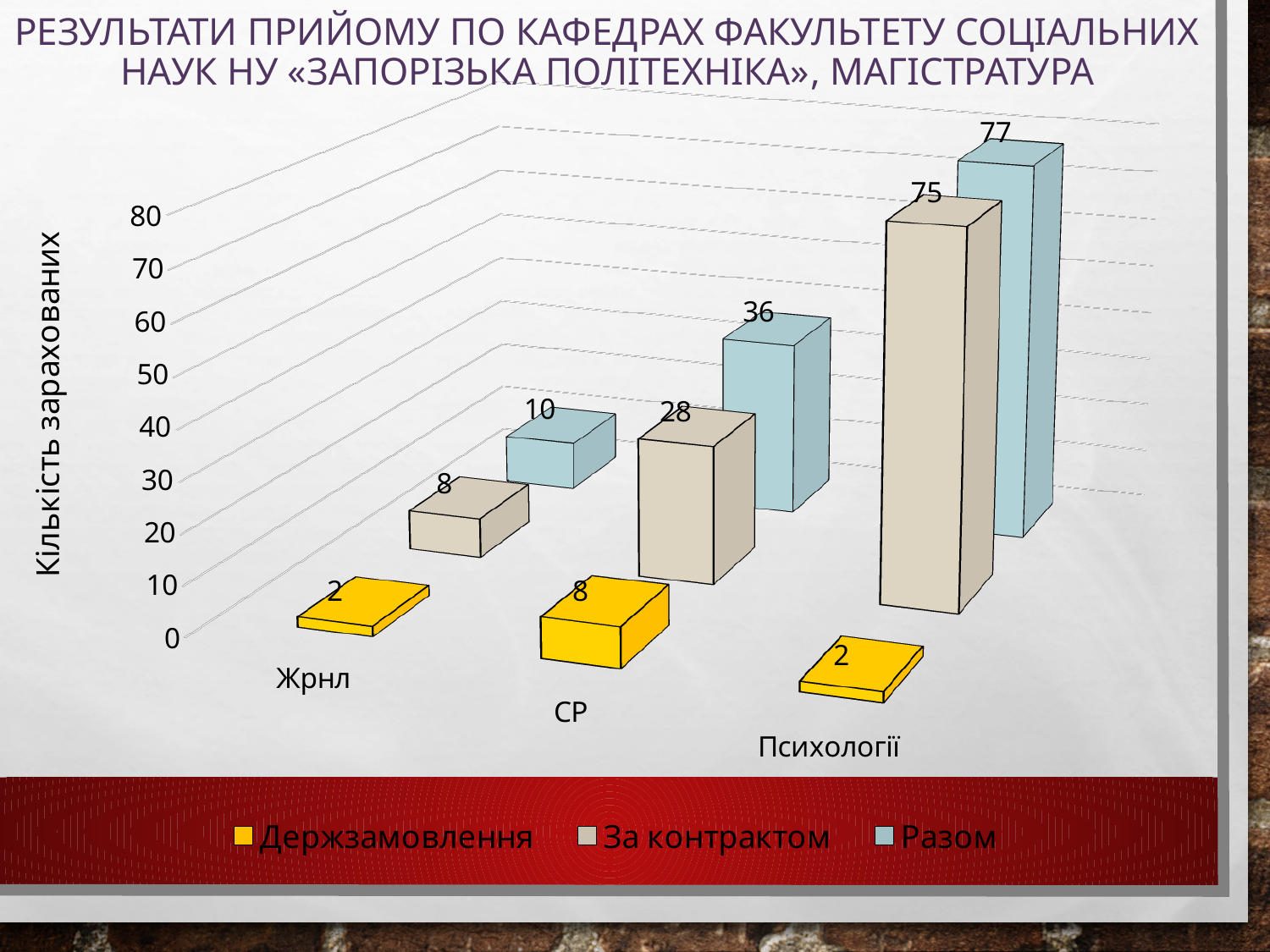
What is the label of the vertical axis? Кількість зарахованих What is the difference between the Разом values for Психології and СР? 41 Which series is shown in yellow? Держзамовлення What is the value of Держзамовлення for Жрнл? 2 Which category has the highest Разом value? Психології Which is larger: Держзамовлення for СР or Держзамовлення for Психології? Держзамовлення for СР How many categories are shown on the x axis? 3 Which category has the lowest За контрактом value? Жрнл What is the value of За контрактом for СР? 28 What kind of chart is shown on the slide? Bar chart What is the value of Разом for Психології? 77 How many series does the legend list? 3